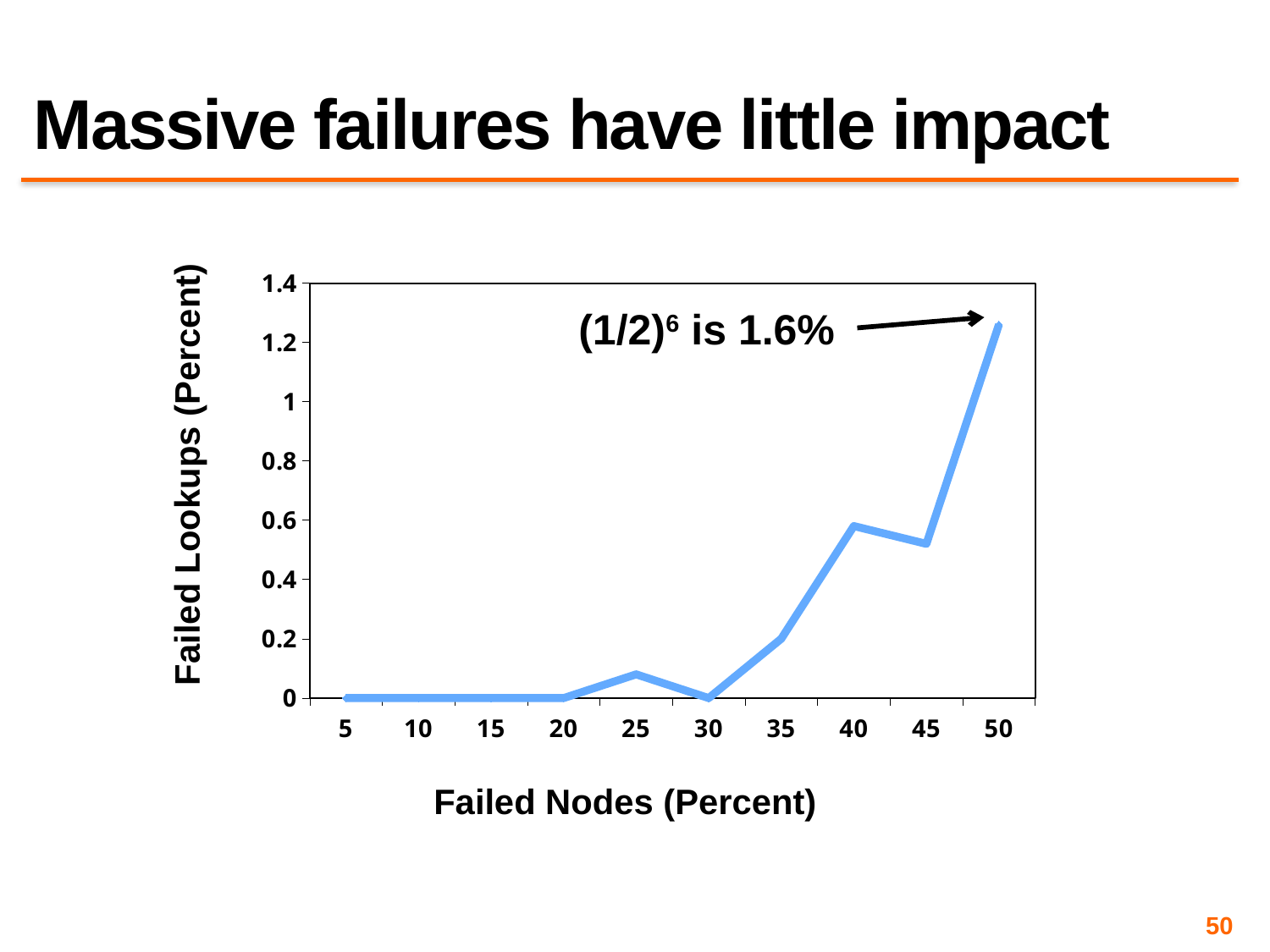
Overall, do Failed Lookups rise or fall as Failed Nodes increases from 5 to 50? rise What is the label of the x axis? Failed Nodes (Percent) Is the Failed Lookups value at 40 percent failed nodes greater or less than 0.4? greater What kind of chart is shown on the slide? line chart Is the Failed Lookups value at 25 percent failed nodes greater or less than 0.2? less What is the Failed Lookups (Percent) value when Failed Nodes is 30? 0 Is the Failed Lookups value at 50 percent failed nodes greater or less than 1? greater What is the Failed Lookups (Percent) value when Failed Nodes is 10? 0 Which has a higher Failed Lookups value: 40 percent failed nodes or 50 percent failed nodes? 50 What is the title of the slide containing the chart? Massive failures have little impact At which value of Failed Nodes (Percent) is the Failed Lookups value highest? 50 How many data points are plotted on the line? 10